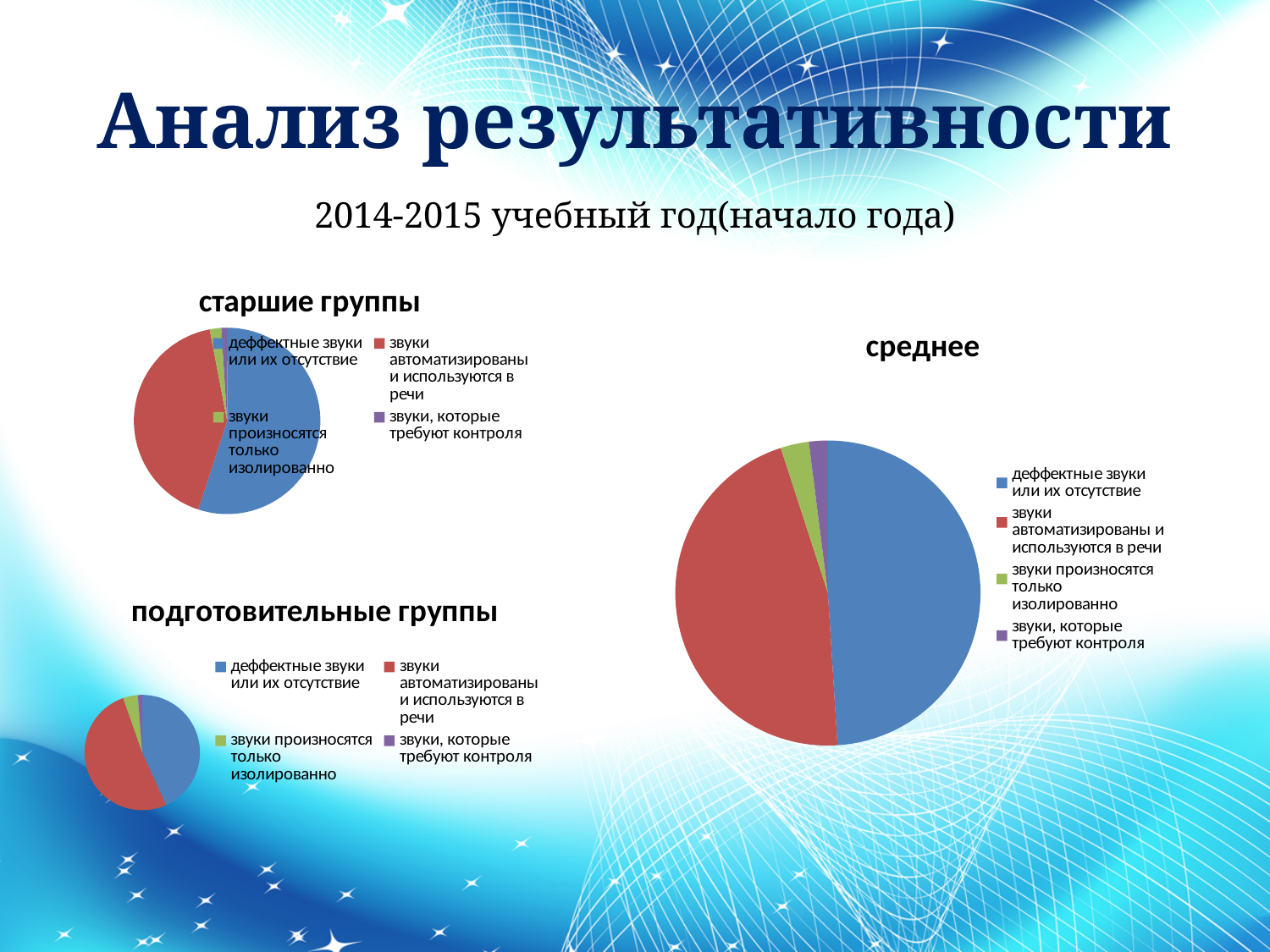
What is the title of the chart on the right side of the slide? среднее How many slices does the "подготовительные группы" pie chart have? 4 What kind of chart is the "среднее" chart? pie chart In the "среднее" chart, which slice is the smallest? звуки, которые требуют контроля In the "среднее" chart, which slice is larger: "звуки произносятся только изолированно" or "звуки, которые требуют контроля"? звуки произносятся только изолированно In the "подготовительные группы" chart, which slice is larger: "деффектные звуки или их отсутствие" or "звуки автоматизированы и используются в речи"? звуки автоматизированы и используются в речи In the "старшие группы" chart, which slice is the smallest? звуки, которые требуют контроля What kind of chart is the "старшие группы" chart? pie chart In the "подготовительные группы" chart, which slice is the largest? звуки автоматизированы и используются в речи How many categories does the legend of the "среднее" chart list? 4 In the "подготовительные группы" chart, which slice is the smallest? звуки, которые требуют контроля What colour represents "звуки автоматизированы и используются в речи" in the "среднее" chart? red